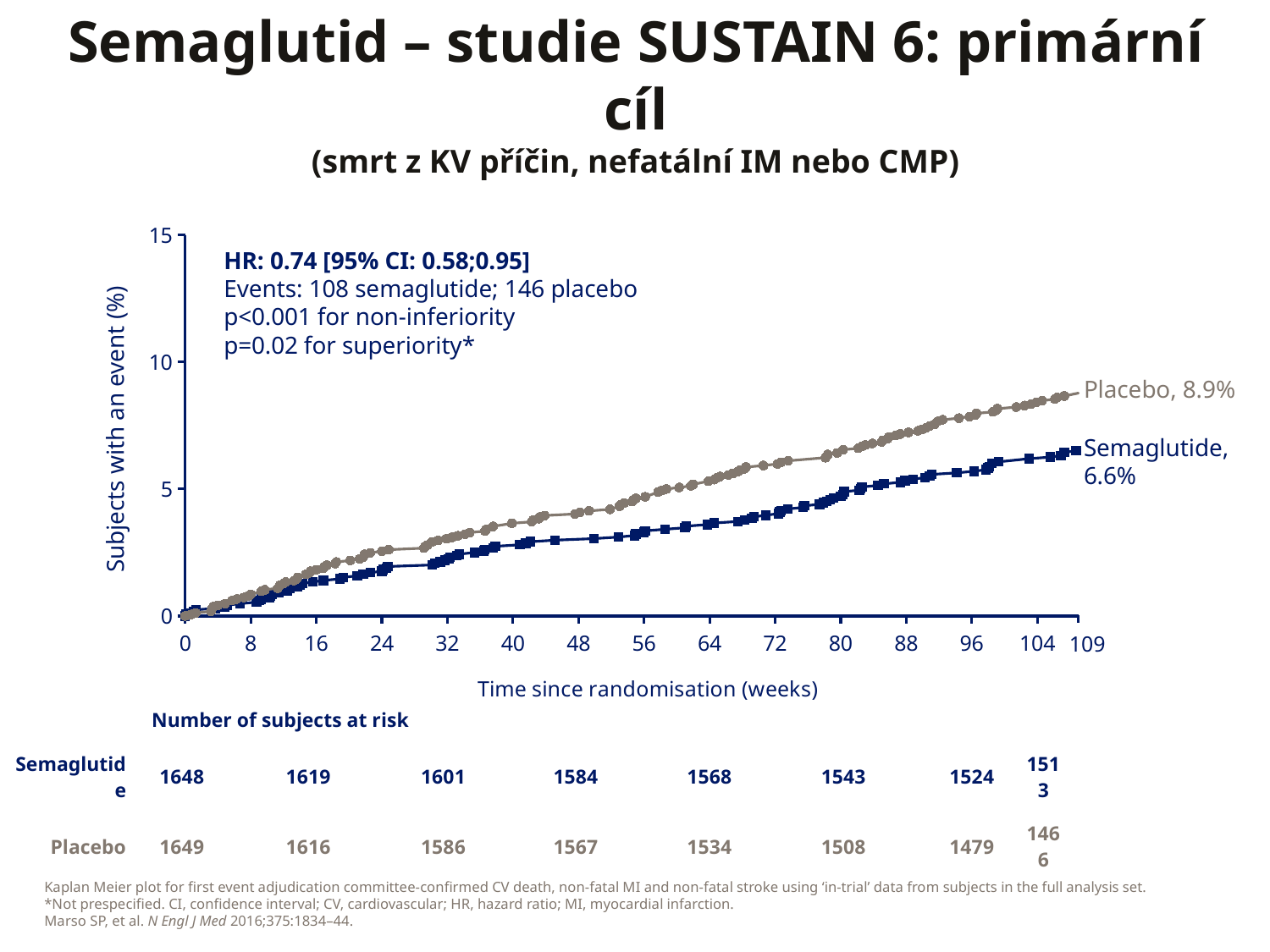
Is the final Semaglutide event rate greater or less than 5%? greater Which group has the higher event rate at the end of the curve, Placebo or Semaglutide? Placebo What type of chart is shown on the slide? Line chart (Kaplan-Meier plot) Is the final Placebo event rate greater or less than 10%? less What is the final event rate shown for the Placebo curve? 8.9% What is the difference between the final Placebo and Semaglutide event rates? 2.3% How many events are reported for the semaglutide group? 108 Do the event curves rise or fall as time since randomisation increases? Rise How many series (treatment groups) are plotted on the chart? 2 What is the label of the y-axis? Subjects with an event (%) What hazard ratio is reported on the chart? 0.74 [95% CI: 0.58;0.95] What is the final event rate shown for the Semaglutide curve? 6.6%